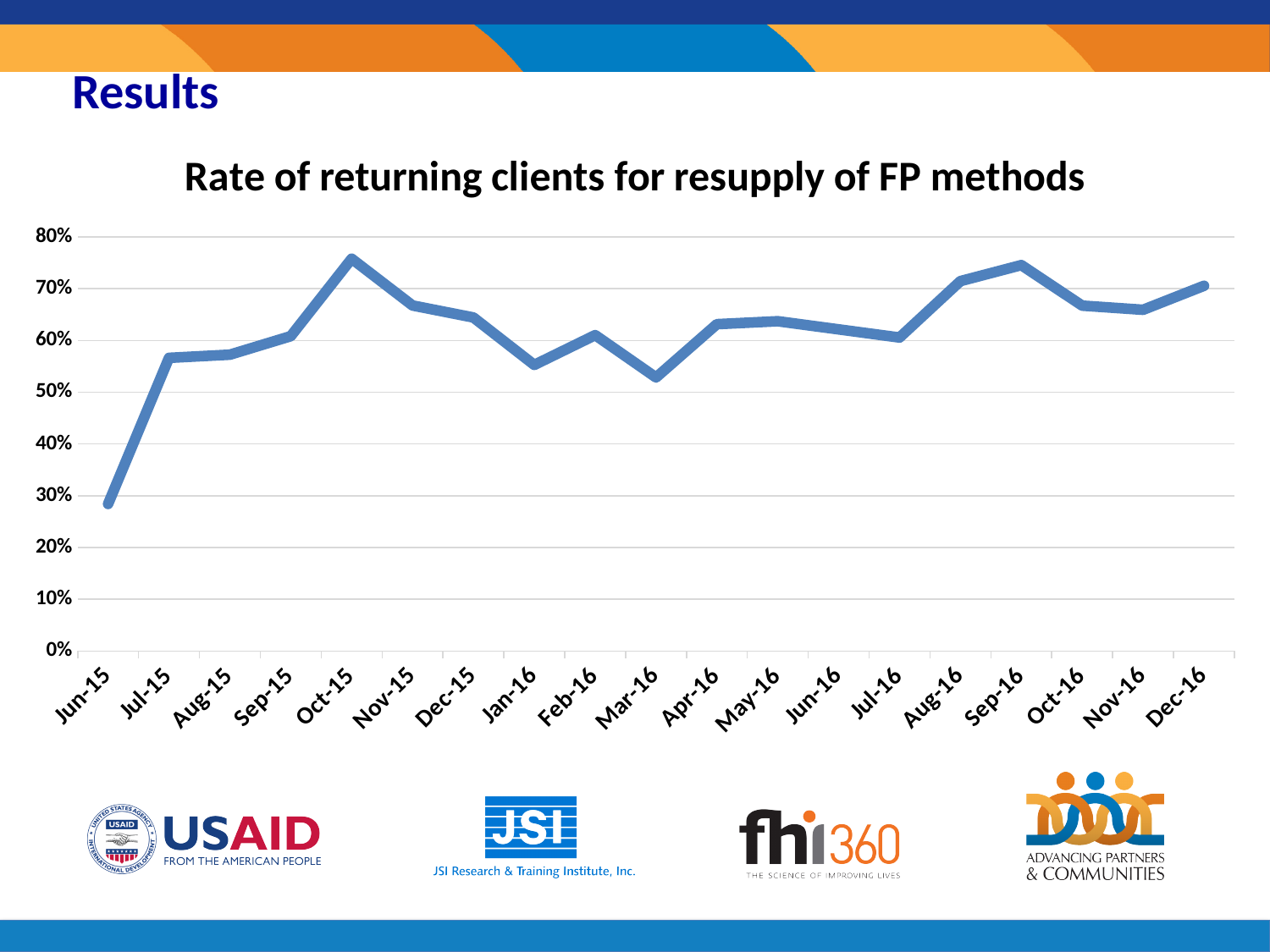
What is the title of the chart? Rate of returning clients for resupply of FP methods What kind of chart is shown on the slide? line chart Which month has the lowest rate of returning clients? Jun-15 Which is larger, the value for Jun-15 or the value for Jul-15? Jul-15 Does the rate rise or fall from Jun-15 to Oct-15? rise Is the value for Jan-16 greater or less than 60%? less Which is larger, the value for Mar-16 or the value for Apr-16? Apr-16 Is the value for Oct-15 greater or less than 70%? greater Is the value for Sep-16 greater or less than 70%? greater How many months are plotted along the x axis? 19